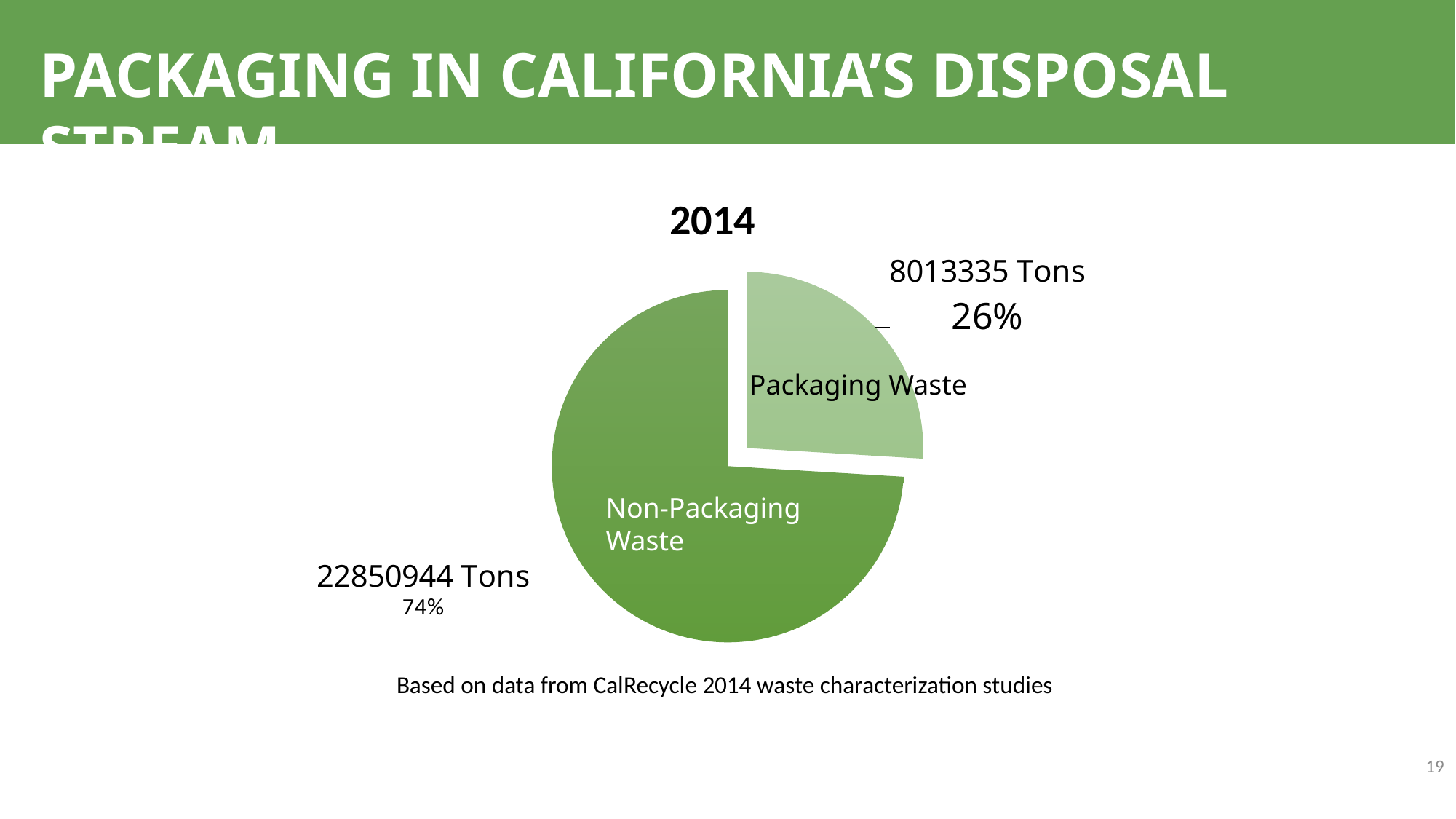
What share of the pie does Non-Packaging Waste represent? 74% What type of chart is shown on the slide? Pie chart What is the difference in tons between Non-Packaging Waste and Packaging Waste? 14837609 Tons Which slice of the pie chart is the smallest? Packaging Waste What is the total tonnage of the two slices in the pie chart? 30864279 Tons Which is larger, Packaging Waste or Non-Packaging Waste? Non-Packaging Waste How many tons of Non-Packaging Waste are shown in the chart? 22850944 Tons Which slice of the pie chart is the largest? Non-Packaging Waste How many tons of Packaging Waste are shown in the chart? 8013335 Tons What share of the pie does Packaging Waste represent? 26% What is the title of the chart? 2014 How many slices does the pie chart have? 2